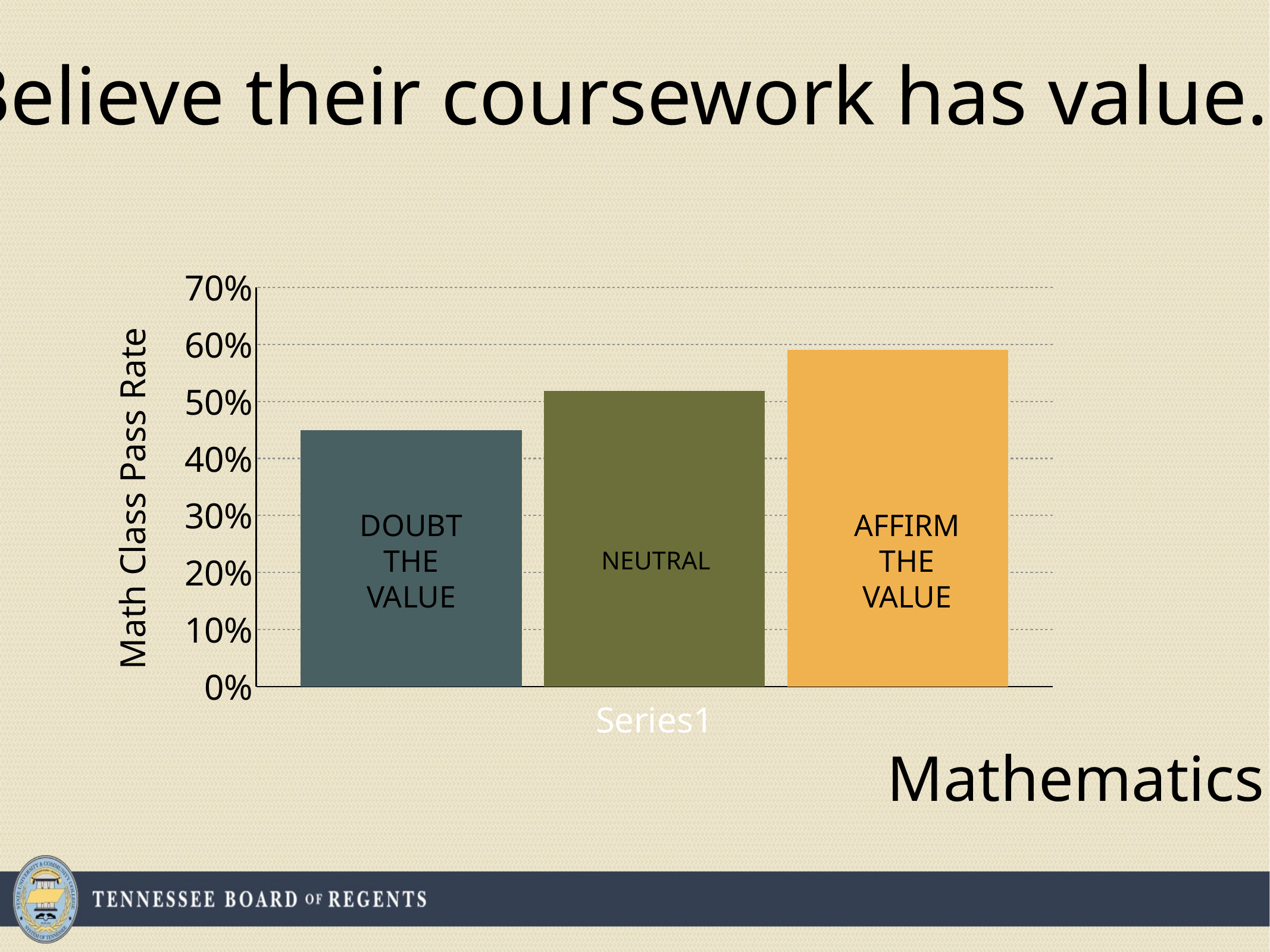
What is the highest value shown on the vertical axis? 70% Which has a higher pass rate, AFFIRM THE VALUE or NEUTRAL? AFFIRM THE VALUE Is the value for DOUBT THE VALUE greater or less than 50%? less Which category has the highest math class pass rate? AFFIRM THE VALUE Which has a higher pass rate, NEUTRAL or DOUBT THE VALUE? NEUTRAL Which category has the lowest math class pass rate? DOUBT THE VALUE Do the bar values rise or fall from left to right across the chart? rise Is the value for AFFIRM THE VALUE greater or less than 50%? greater What kind of chart is shown on the slide? bar chart What is the title of the vertical axis? Math Class Pass Rate Is the value for NEUTRAL greater or less than 60%? less How many bars are plotted in the chart? 3